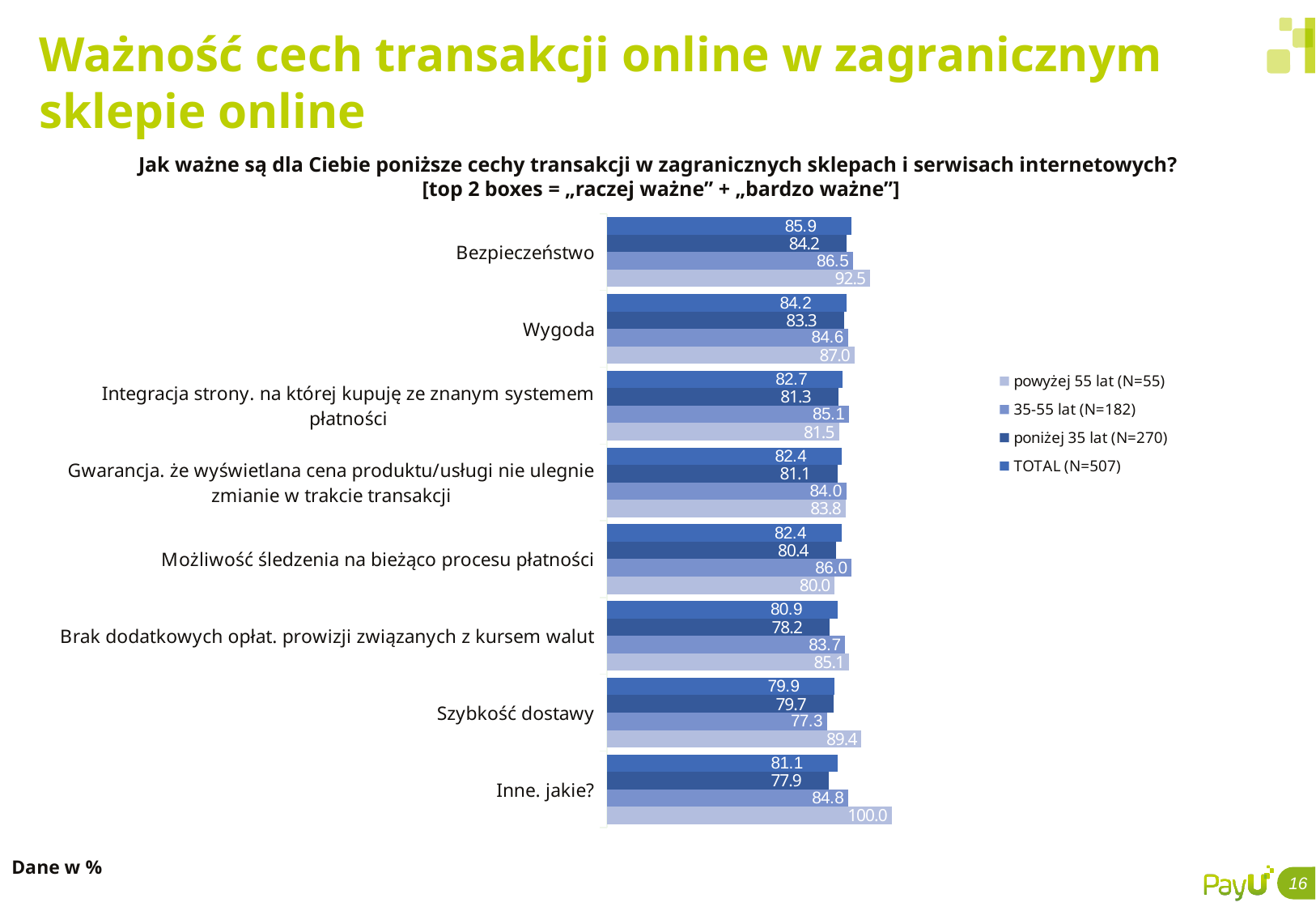
How many categories are shown on the chart? 8 Which category has the highest TOTAL (N=507) value? Bezpieczeństwo How many series does the legend list? 4 What is the sample size (N) for the TOTAL series in the legend? 507 What is the difference between the powyżej 55 lat (N=55) value and the TOTAL (N=507) value for Inne, jakie? 18.9 For Możliwość śledzenia na bieżąco procesu płatności, which is larger: the 35-55 lat (N=182) value or the poniżej 35 lat (N=270) value? 35-55 lat (N=182) What is the value for Szybkość dostawy in the powyżej 55 lat (N=55) series? 89.4 What is the value for Brak dodatkowych opłat, prowizji związanych z kursem walut in the 35-55 lat (N=182) series? 83.7 What is the TOTAL (N=507) value for Bezpieczeństwo? 85.9 What kind of chart is shown on the slide? Bar chart Which category has the lowest value in the 35-55 lat (N=182) series? Szybkość dostawy What is the value for Wygoda in the poniżej 35 lat (N=270) series? 83.3